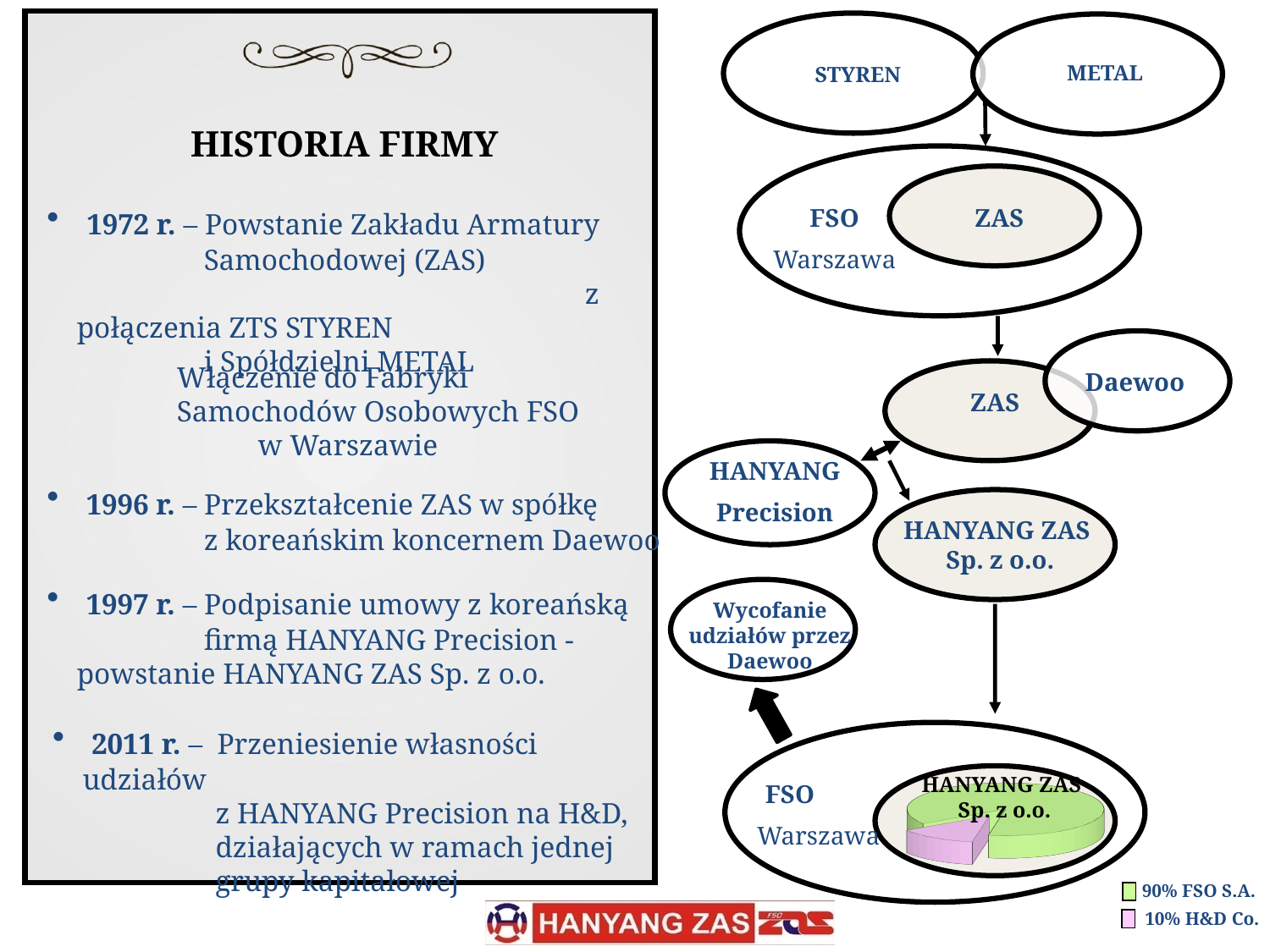
In the pie chart, which is larger: the share of FSO S.A. or the share of H&D Co.? FSO S.A. What share of the pie chart belongs to H&D Co.? 10% What kind of chart is shown inside the bottom ellipse of the diagram? Pie chart How many entries does the legend of the pie chart list? 2 How many slices does the pie chart have? 2 Which slice of the pie chart is the largest? FSO S.A. What colour represents FSO S.A. in the pie chart legend? Green What colour represents H&D Co. in the pie chart legend? Pink By how many percentage points does the FSO S.A. share exceed the H&D Co. share in the pie chart? 80 percentage points Which slice of the pie chart is the smallest? H&D Co. What share of the pie chart belongs to FSO S.A.? 90%